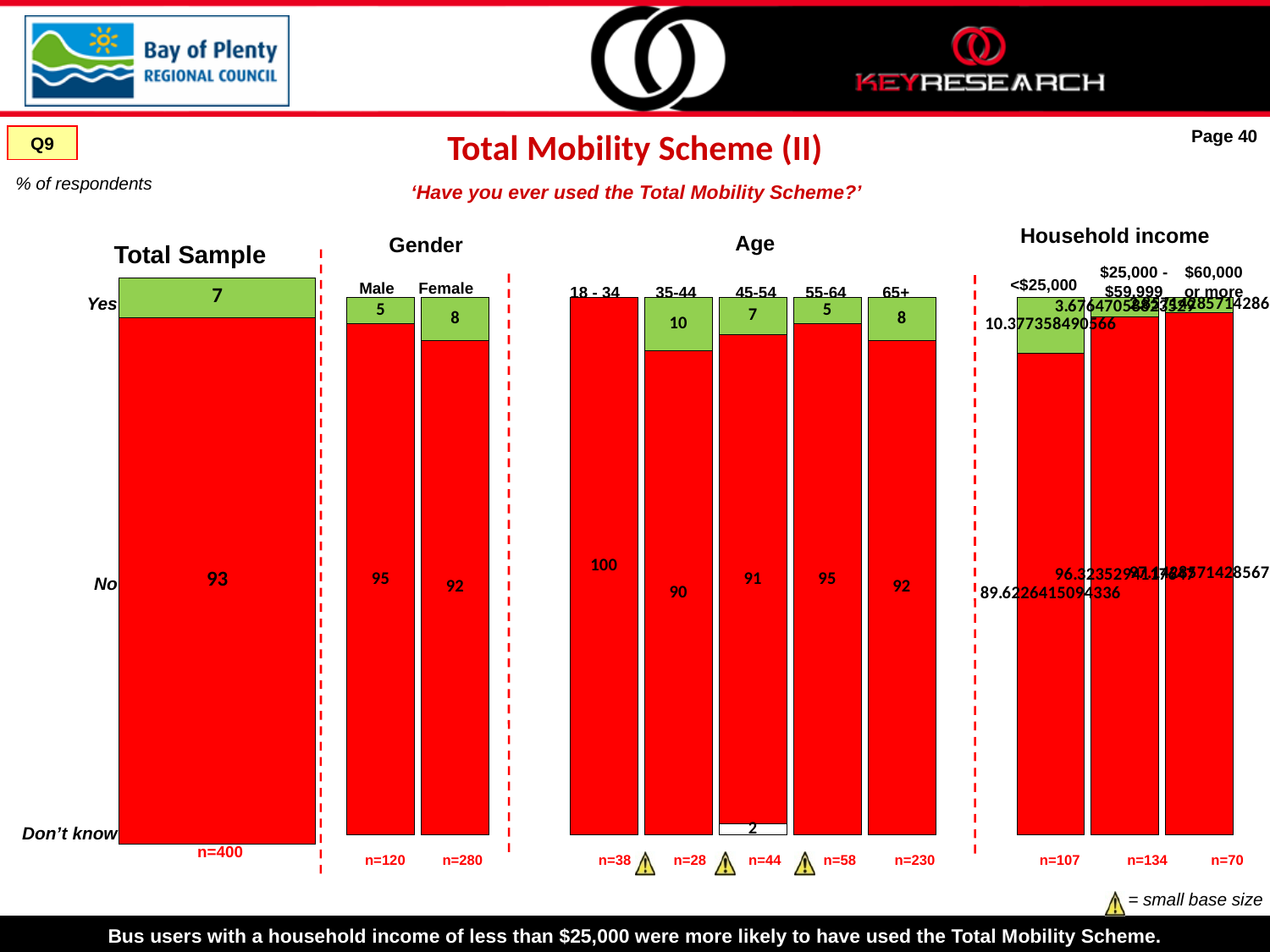
In the Gender chart, what is the 'Yes' value for Female? 8 In the Total Sample chart, what percentage of respondents answered 'Yes'? 7 What is the base size (n) shown under the Total Sample chart? n=400 In the Age chart, which has the larger 'No' value, 55-64 or 65+? 55-64 In the Gender chart, what is the 'No' value for Male? 95 In the Age chart, which age group has the highest 'Yes' value? 35-44 In the Age chart, what is the 'No' value for the 18 - 34 group? 100 How many age groups are shown in the Age chart? 5 In the Total Sample chart, what percentage of respondents answered 'No'? 93 In the Age chart, what is the 'Don't know' value for the 45-54 group? 2 In the Gender chart, how much higher is the 'Yes' value for Female than for Male? 3 What kind of chart is used to show the Total Sample results? Stacked bar chart